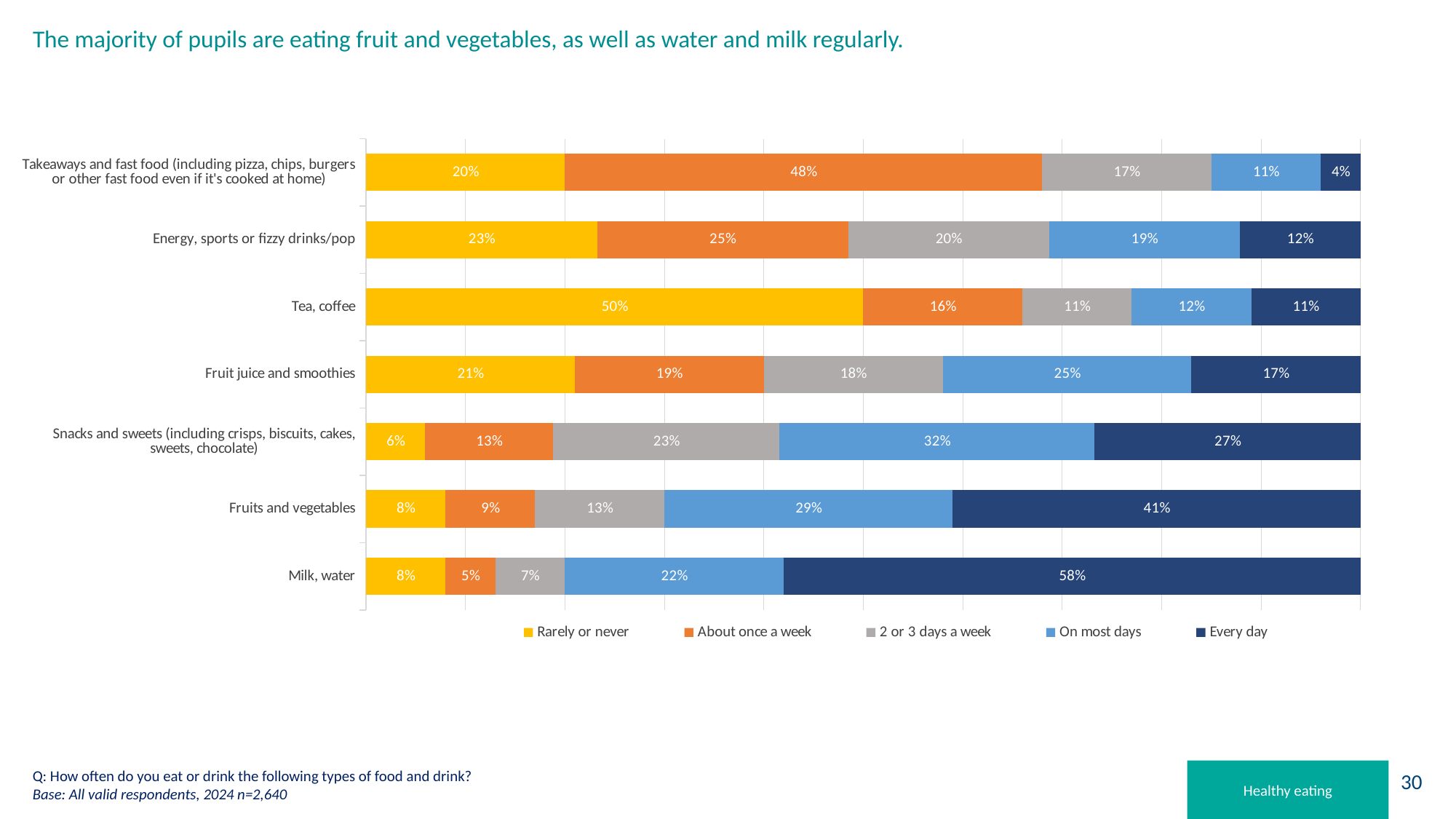
What percentage of pupils say they eat fruits and vegetables every day? 41% Which is larger: the 'On most days' percentage for snacks and sweets or for fruit juice and smoothies? Snacks and sweets Which category has the lowest 'Every day' percentage? Takeaways and fast food How many food and drink categories are shown in the chart? 7 Which legend entry is shown in yellow? Rarely or never Which category has the highest 'Every day' percentage? Milk, water How many series does the legend list? 5 What kind of chart is shown on the slide? Stacked bar chart What percentage of pupils say they rarely or never have tea or coffee? 50% What percentage of pupils say they have takeaways and fast food about once a week? 48% What is the total of the stacked bar for energy, sports or fizzy drinks/pop? 99% What is the difference between the 'Every day' percentages for milk, water and fruits and vegetables? 17%